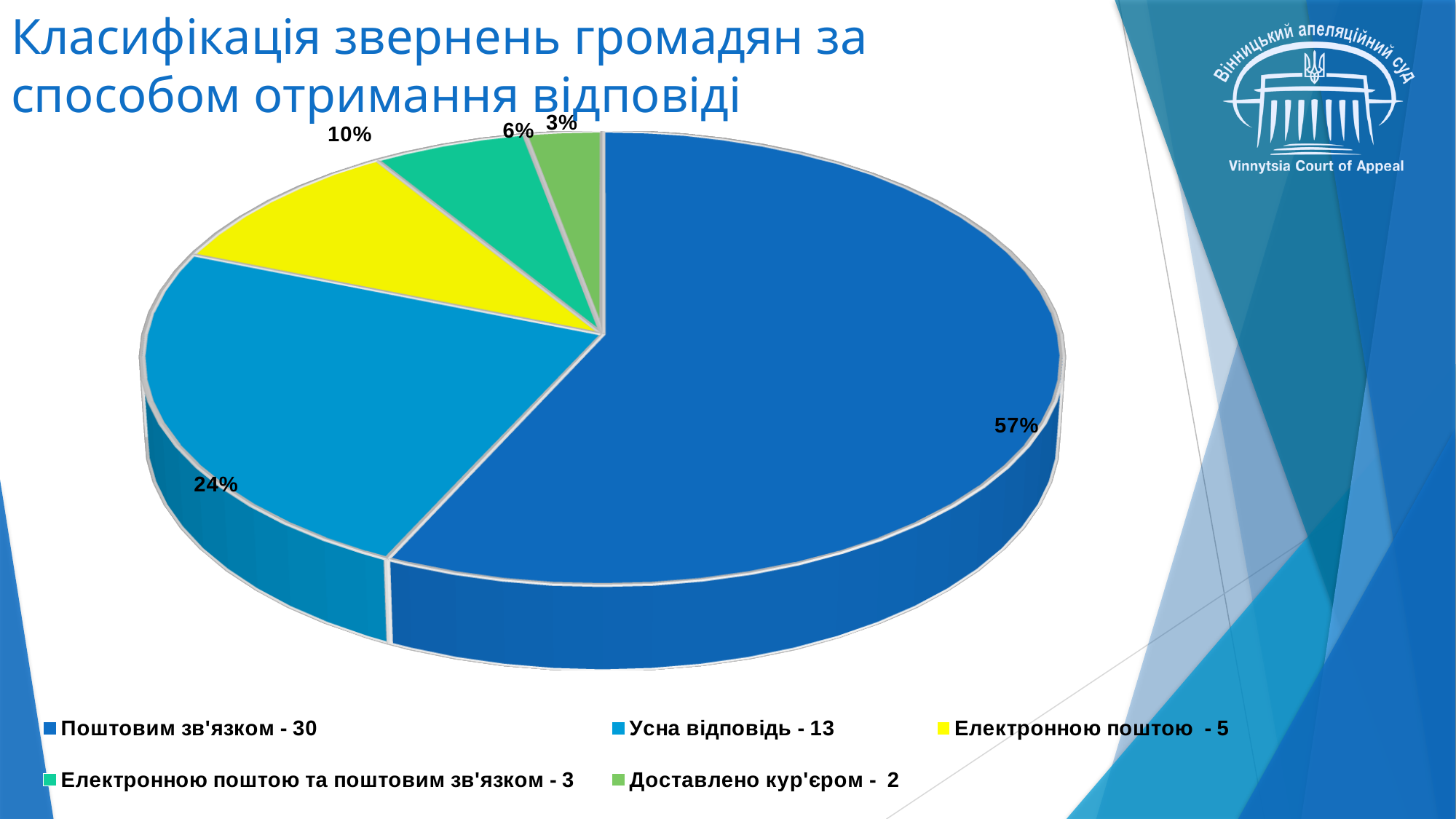
How many categories does the pie chart show? 5 What percentage share does the slice for "Усна відповідь" have? 24% What percentage share does the slice for "Доставлено кур'єром" have? 3% Which slice is larger: "Електронною поштою" or "Доставлено кур'єром"? Електронною поштою What percentage share does the slice for "Електронною поштою" have? 10% What kind of chart is shown on the slide? pie chart Which category has the largest slice of the pie? Поштовим зв'язком What is the title of the chart on the slide? Класифікація звернень громадян за способом отримання відповіді What is the difference in percentage points between the "Поштовим зв'язком" slice and the "Усна відповідь" slice? 33% Which category has the smallest slice of the pie? Доставлено кур'єром